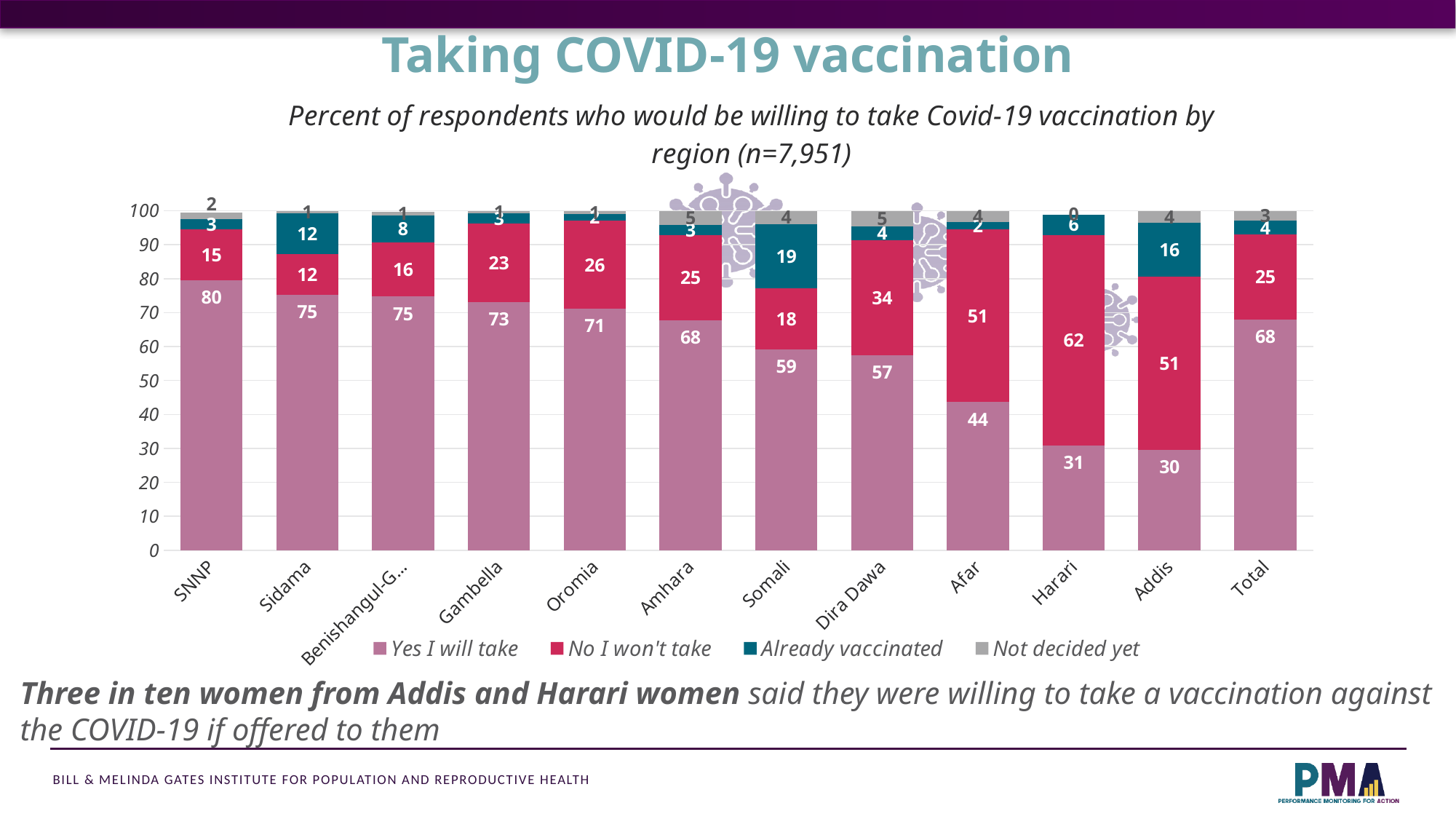
How many bars (regions including Total) are shown on the x axis? 12 What is the "Yes I will take" value for the Total bar? 68 Which region has the highest "No I won't take" value? Harari Which legend series is shown in dark teal? Already vaccinated What is the "No I won't take" value for Harari? 62 Which region has the highest "Yes I will take" value? SNNP What is the "Already vaccinated" value for Somali? 19 What kind of chart is shown on the slide? Stacked bar chart Which has a larger "Already vaccinated" value, Somali or Addis? Somali What percentage of respondents in SNNP said "Yes I will take"? 80 What is the difference between the "Yes I will take" values for SNNP and Addis? 50 How many series does the legend list? 4